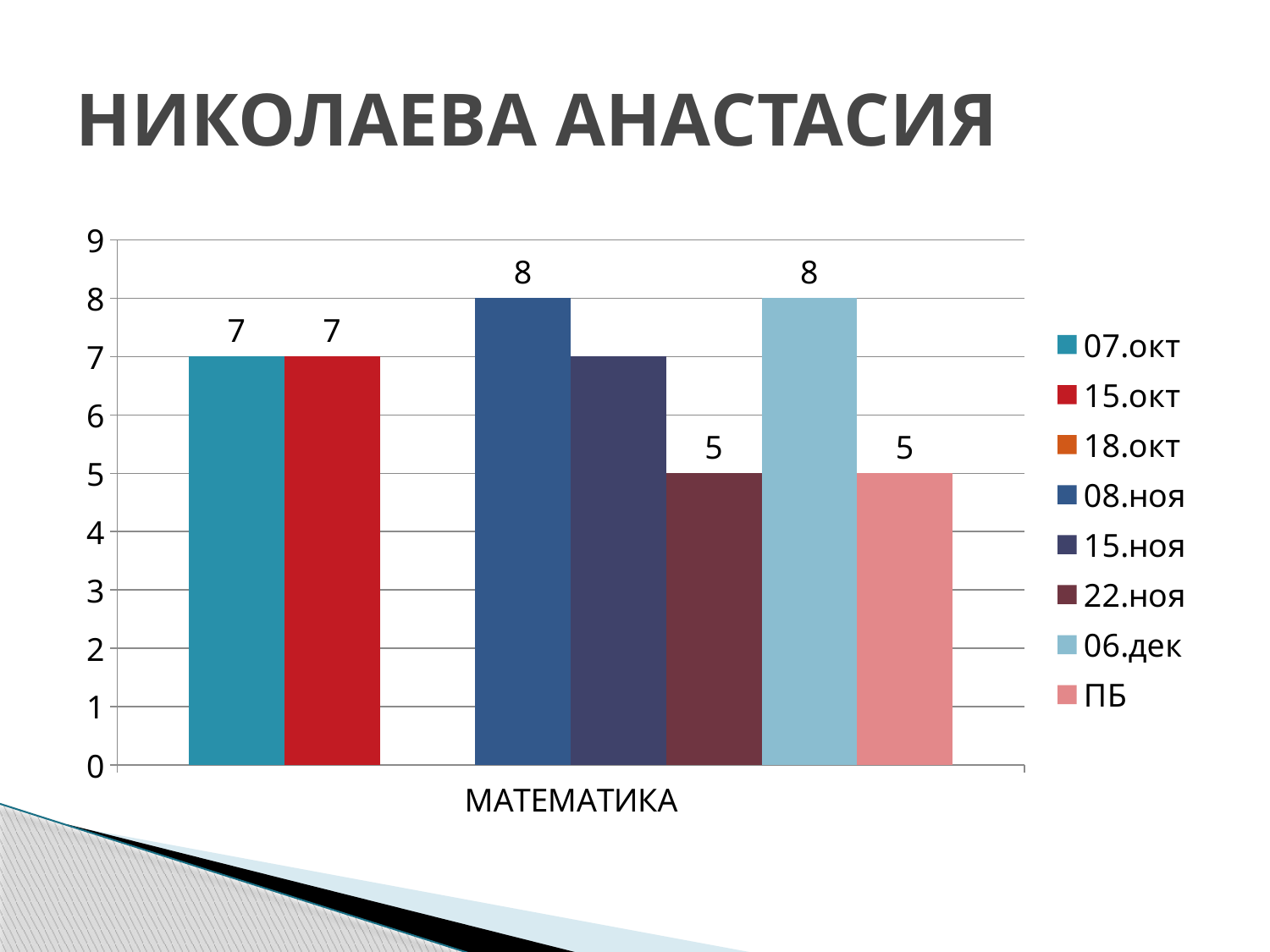
What is the value for 22.ноя in the МАТЕМАТИКА chart? 5 What is the title of the slide? НИКОЛАЕВА АНАСТАСИЯ What is the value for 07.окт in the МАТЕМАТИКА chart? 7 What kind of chart is shown on the slide? bar chart What is the value for 06.дек in the МАТЕМАТИКА chart? 8 Which is larger, the value for 15.окт or the value for ПБ? 15.окт Is the value for 15.ноя greater or less than 6? greater How many series does the legend list? 8 What is the difference between the values for 08.ноя and 22.ноя? 3 What is the category label shown on the x axis? МАТЕМАТИКА What is the value for 08.ноя in the МАТЕМАТИКА chart? 8 What is the value for ПБ in the МАТЕМАТИКА chart? 5